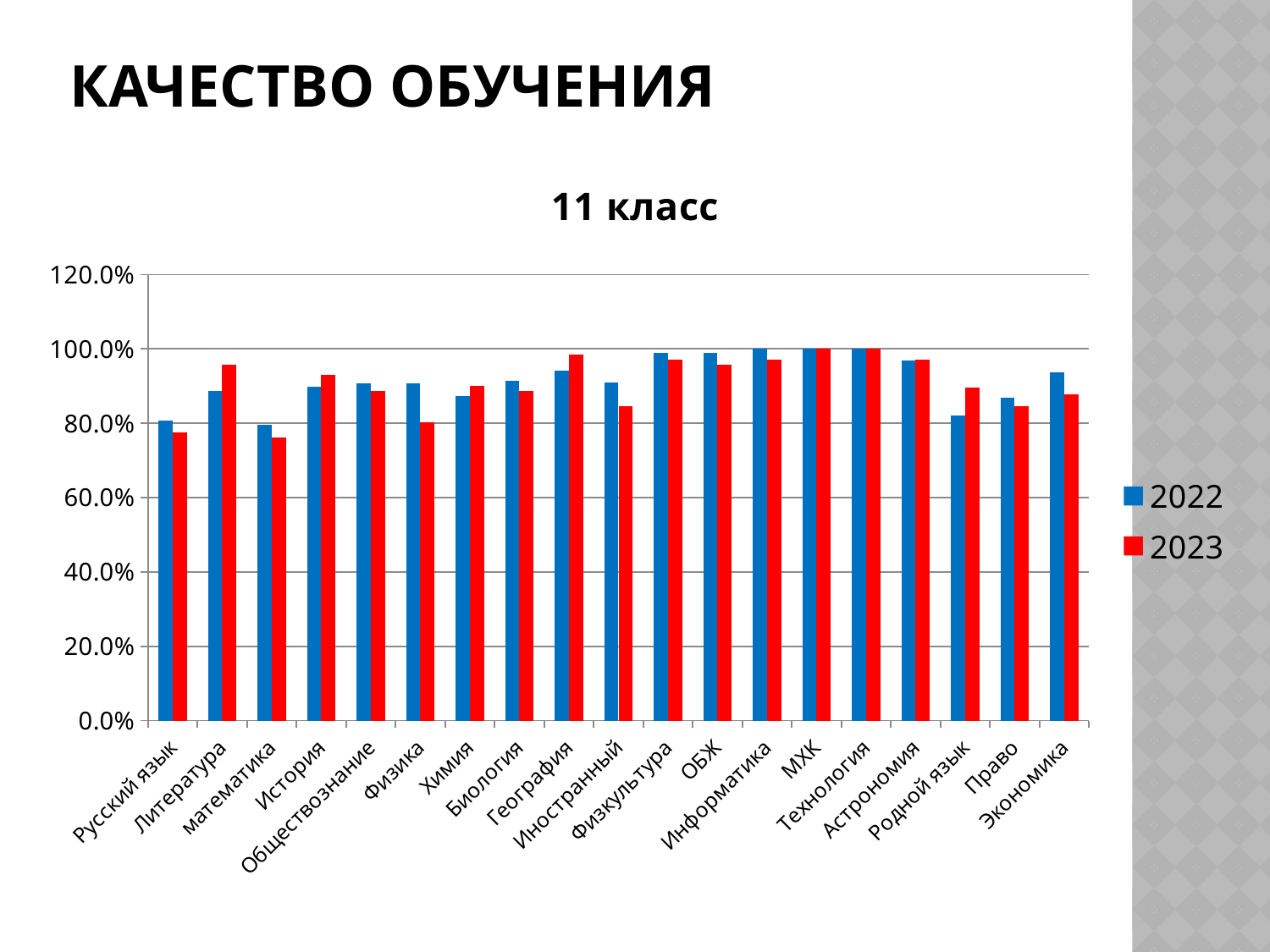
Is the 2023 value for Литература greater or less than 80.0%? greater What is the title of the chart? 11 класс Which colour represents the 2023 series in the legend? red For Физика, which year has the larger value, 2022 or 2023? 2022 For Литература, which year has the larger value, 2022 or 2023? 2023 For Родной язык, which year has the larger value, 2022 or 2023? 2023 How many series does the legend list? 2 Is the 2022 value for Экономика greater or less than 80.0%? greater Is the 2023 value for математика greater or less than 80.0%? less What kind of chart is shown on the slide? bar chart How many subject categories are shown on the x axis? 19